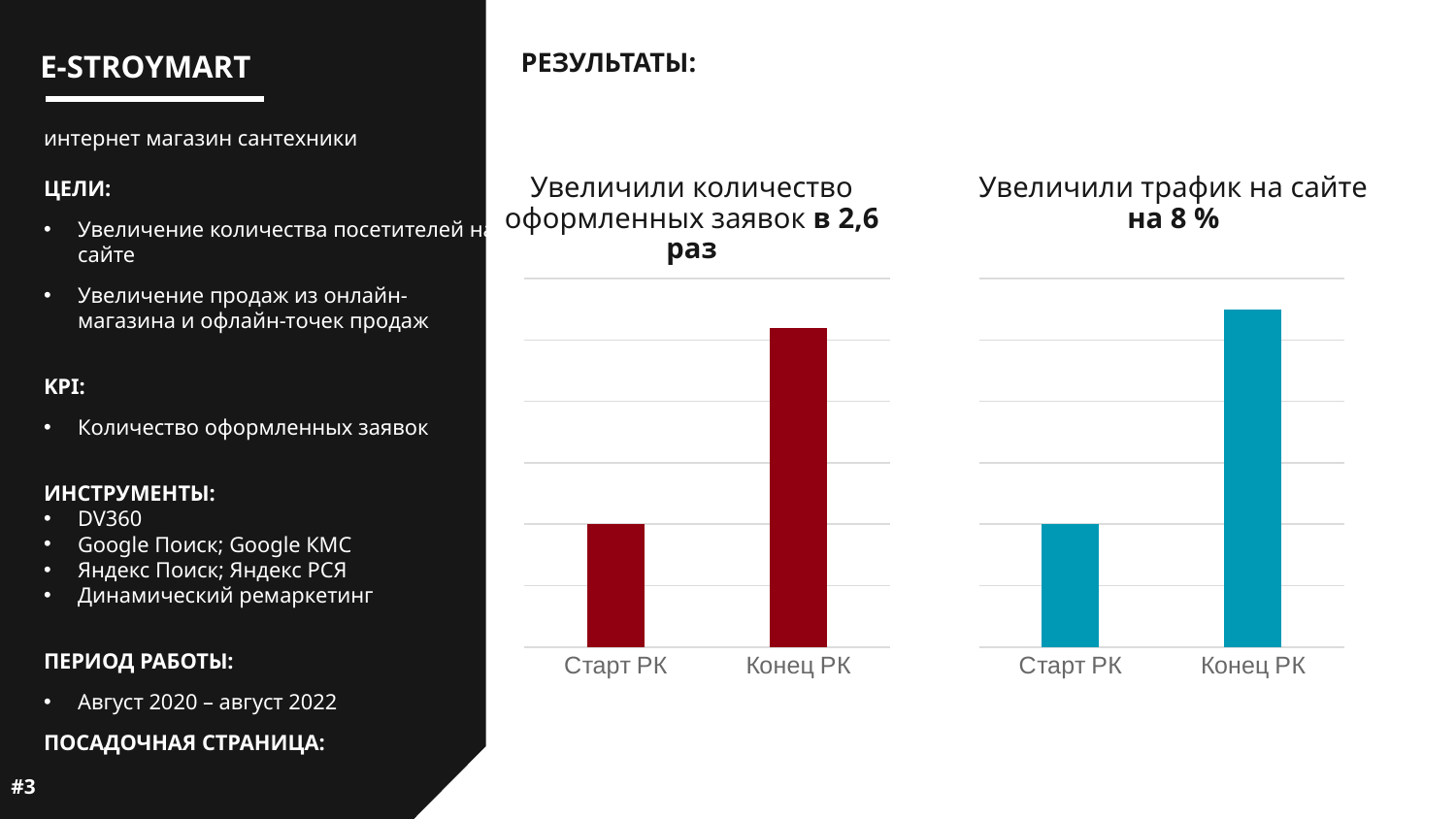
What kind of chart is the right chart titled 'Увеличили трафик на сайте на 8 %'? bar chart In the left chart (оформленных заявок), how many categories are shown on the x axis? 2 In the left chart (оформленных заявок), which is larger: Старт РК or Конец РК? Конец РК In the right chart (трафик на сайте), how many bars are plotted? 2 What kind of chart is the left chart titled 'Увеличили количество оформленных заявок в 2,6 раз'? bar chart In the left chart (оформленных заявок), which category has the highest bar? Конец РК In the left chart (оформленных заявок), which category has the lowest bar? Старт РК In the right chart (трафик на сайте), which category has the highest bar? Конец РК By how many times did the number of completed applications increase, according to the left chart's title? в 2,6 раз What colour are the bars in the right chart (трафик на сайте)? blue In the right chart (трафик на сайте), which category has the lowest bar? Старт РК In the right chart (трафик на сайте), do the values rise or fall from Старт РК to Конец РК? rise